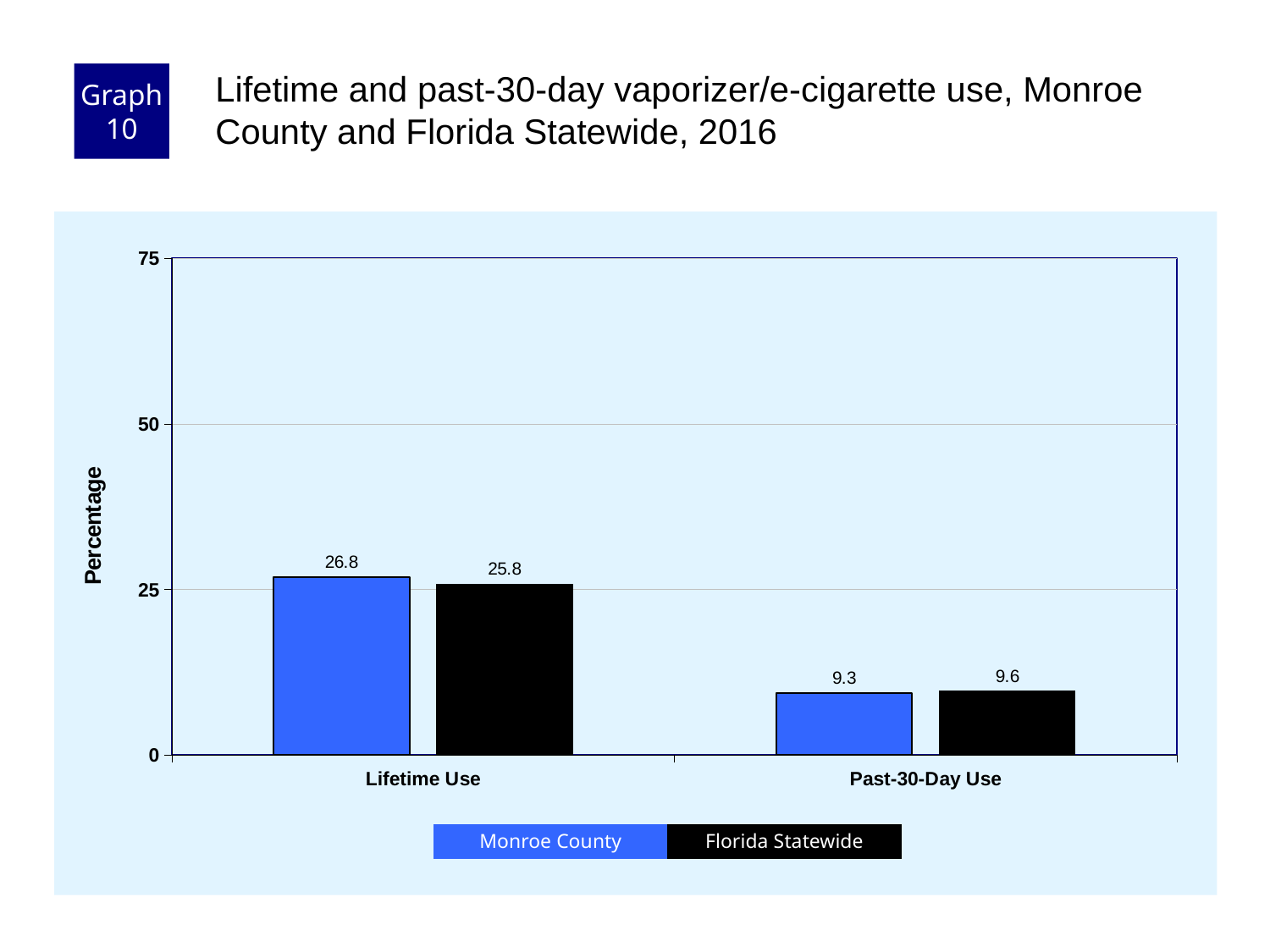
Which bar has the lowest value on the chart? Monroe County, Past-30-Day Use How many categories are shown on the x axis? 2 Which bar has the highest value on the chart? Monroe County, Lifetime Use What is the Florida Statewide value for Lifetime Use? 25.8 What is the Monroe County value for Lifetime Use? 26.8 What is the difference between the Monroe County and Florida Statewide values for Lifetime Use? 1.0 What kind of chart is shown on the slide? bar chart How many series does the legend list? 2 Is the Florida Statewide value for Lifetime Use greater or less than 50? less What is the Monroe County value for Past-30-Day Use? 9.3 For Past-30-Day Use, which is larger: Monroe County or Florida Statewide? Florida Statewide What is the Florida Statewide value for Past-30-Day Use? 9.6